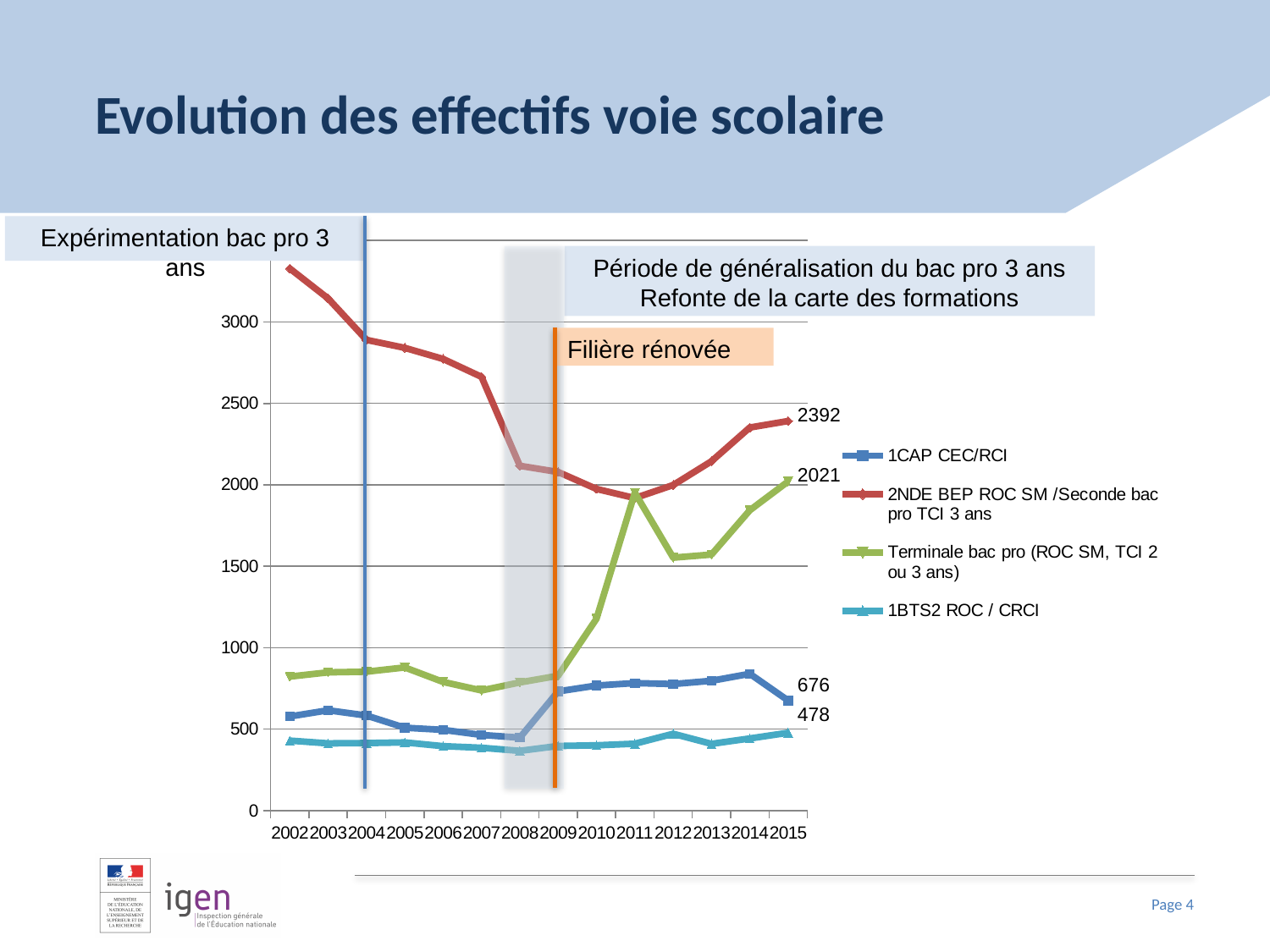
Which series has the highest value in 2015? 2NDE BEP ROC SM /Seconde bac pro TCI 3 ans What kind of chart is shown on the slide? line chart What is the value for the Terminale bac pro (ROC SM, TCI 2 ou 3 ans) series in 2015? 2021 Is the value for the Terminale bac pro series in 2008 greater or less than 1000? less Is the value for the 2NDE BEP ROC SM /Seconde bac pro TCI 3 ans series in 2002 greater or less than 3000? greater What is the value for the 1CAP CEC/RCI series in 2015? 676 What is the difference between the 2015 values of the 1CAP CEC/RCI series and the 1BTS2 ROC / CRCI series? 198 What is the value for the 1BTS2 ROC / CRCI series in 2015? 478 What is the value for the 2NDE BEP ROC SM /Seconde bac pro TCI 3 ans series in 2015? 2392 Which series has the lowest value in 2015? 1BTS2 ROC / CRCI What is the difference between the 2015 values of the 2NDE BEP ROC SM /Seconde bac pro TCI 3 ans series and the Terminale bac pro series? 371 How many series does the legend list? 4